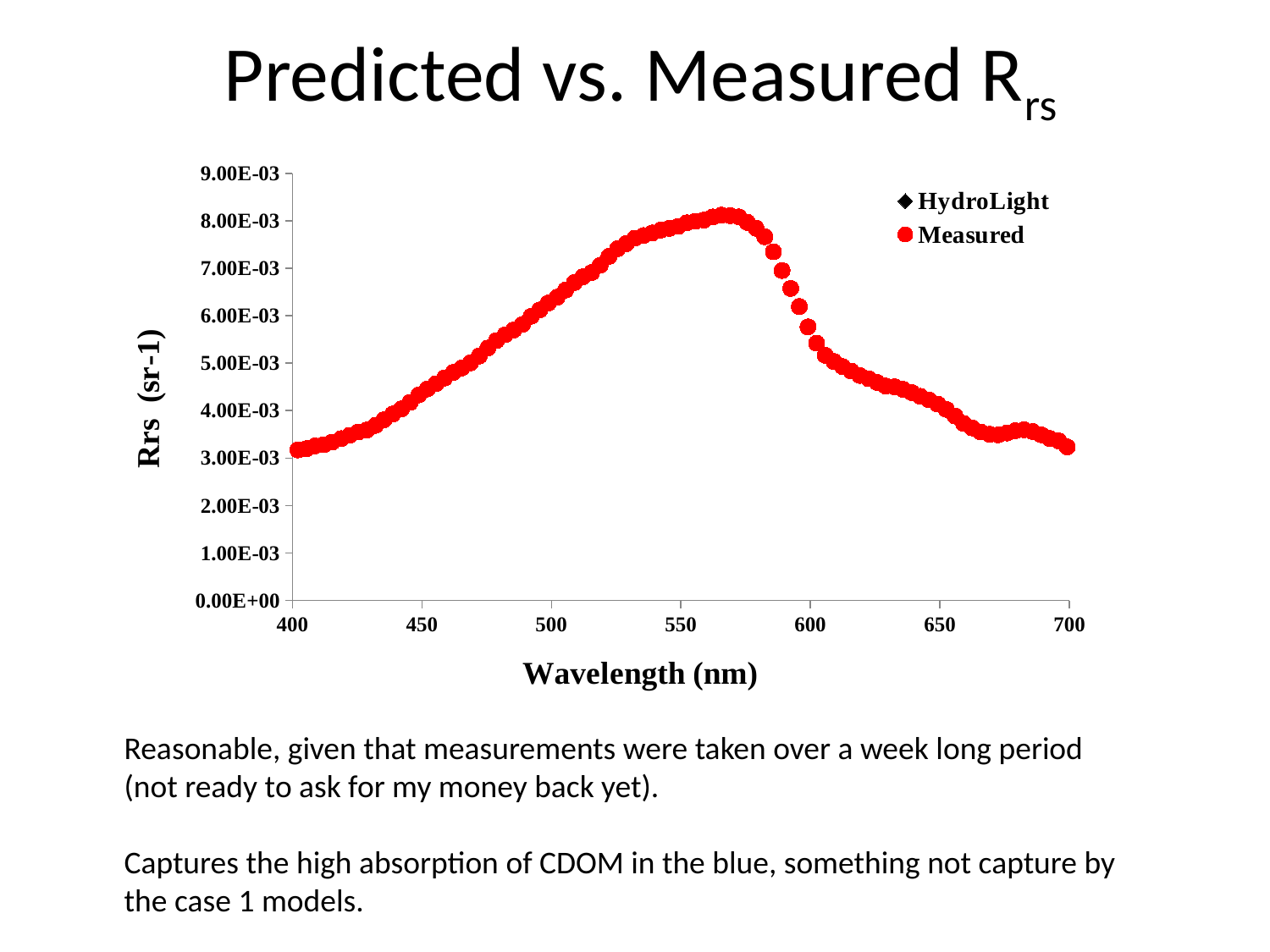
Is the Measured value at 650 nm greater or less than 5.00E-03? less How many series does the legend list? 2 Do the Measured values rise or fall between 400 nm and 550 nm? rise Is the Measured value at 550 nm greater or less than 7.00E-03? greater Is the Measured value at 450 nm greater or less than 5.00E-03? less Do the Measured values rise or fall between 600 nm and 650 nm? fall What is the label of the x axis? Wavelength (nm) What are the two series named in the legend? HydroLight and Measured What kind of chart is shown on the slide? scatter chart Which wavelength has the larger Measured value, 550 nm or 700 nm? 550 nm